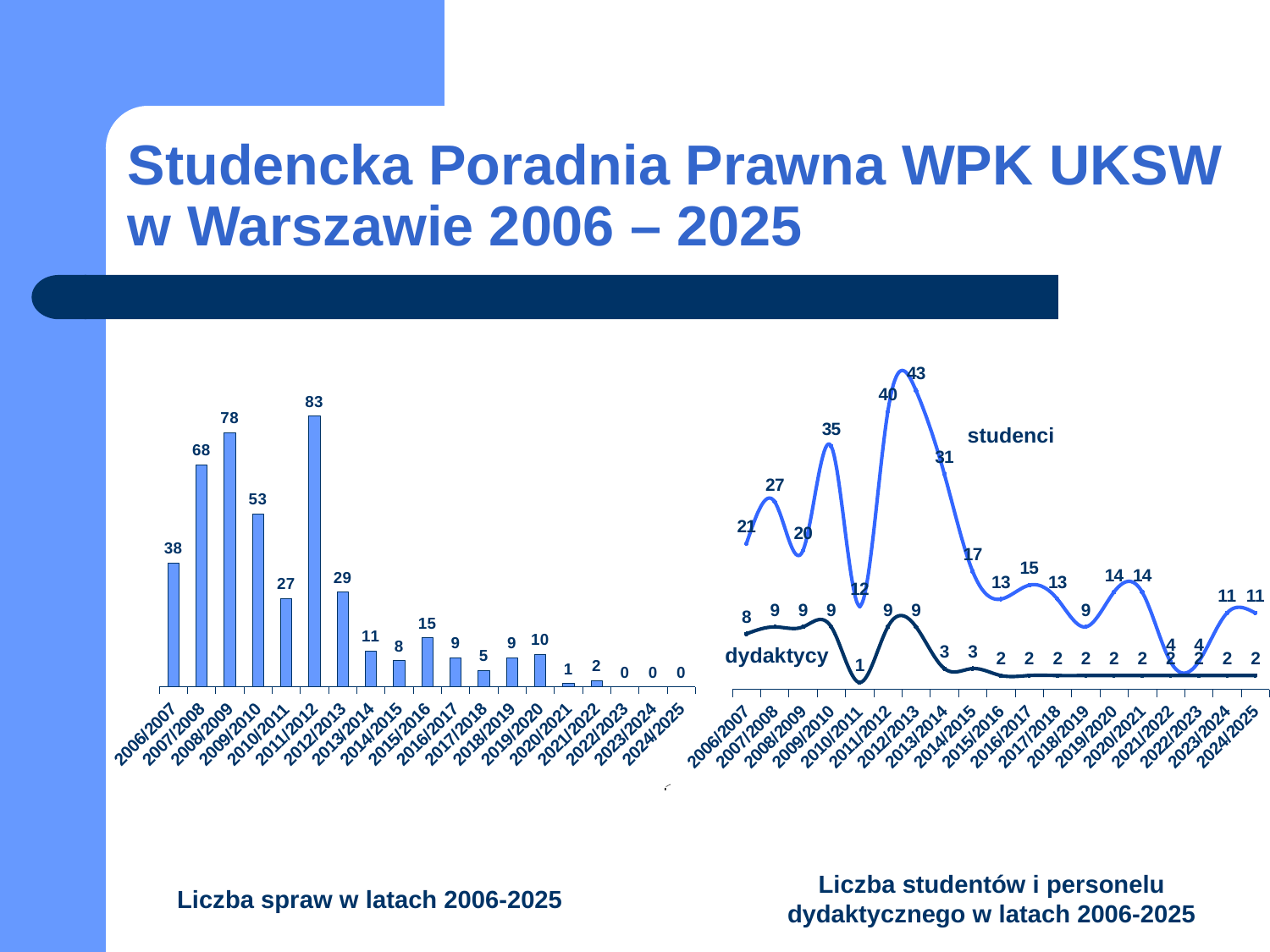
On the chart 'Liczba studentów i personelu dydaktycznego w latach 2006-2025', in which year does the studenci series reach its highest value? 2012/2013 On the chart 'Liczba studentów i personelu dydaktycznego w latach 2006-2025', what is the value of the studenci series for 2012/2013? 43 What kind of chart is 'Liczba spraw w latach 2006-2025'? bar chart On the chart 'Liczba spraw w latach 2006-2025', what is the difference between the values for 2008/2009 and 2007/2008? 10 On the chart 'Liczba spraw w latach 2006-2025', what is the value for 2009/2010? 53 On the chart 'Liczba spraw w latach 2006-2025', how many years are shown on the x axis? 19 On the chart 'Liczba spraw w latach 2006-2025', which is larger: the value for 2013/2014 or the value for 2015/2016? 2015/2016 On the chart 'Liczba studentów i personelu dydaktycznego w latach 2006-2025', what is the difference between the studenci and dydaktycy values for 2011/2012? 31 On the chart 'Liczba studentów i personelu dydaktycznego w latach 2006-2025', what is the value of the dydaktycy series for 2010/2011? 1 On the chart 'Liczba spraw w latach 2006-2025', which year has the highest value? 2011/2012 On the chart 'Liczba spraw w latach 2006-2025', what is the value for 2011/2012? 83 How many series are plotted on the chart 'Liczba studentów i personelu dydaktycznego w latach 2006-2025'? 2